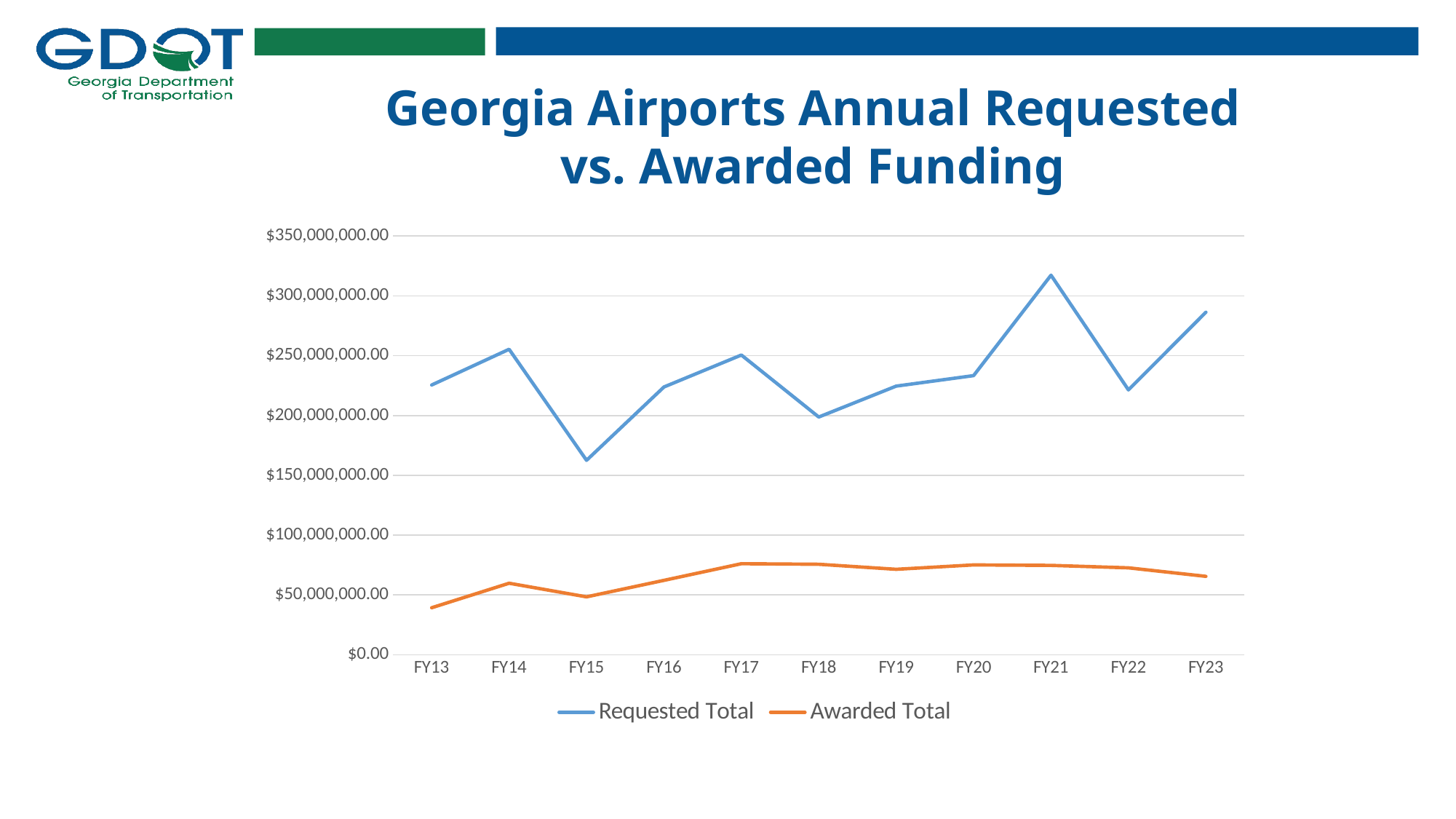
What kind of chart is shown on the slide? Line chart In which fiscal year is the Requested Total lowest? FY15 How many series does the legend list? 2 In which fiscal year is the Requested Total highest? FY21 Is the Requested Total for FY15 greater or less than $200,000,000.00? less Does the Requested Total rise or fall from FY21 to FY22? Falls Is the Requested Total for FY21 greater or less than $300,000,000.00? greater Is the Awarded Total for FY13 greater or less than $50,000,000.00? less What is the title of the chart? Georgia Airports Annual Requested vs. Awarded Funding How many fiscal years are plotted along the x axis? 11 In which fiscal year is the Awarded Total lowest? FY13 Which is larger, the Requested Total for FY14 or for FY15? FY14